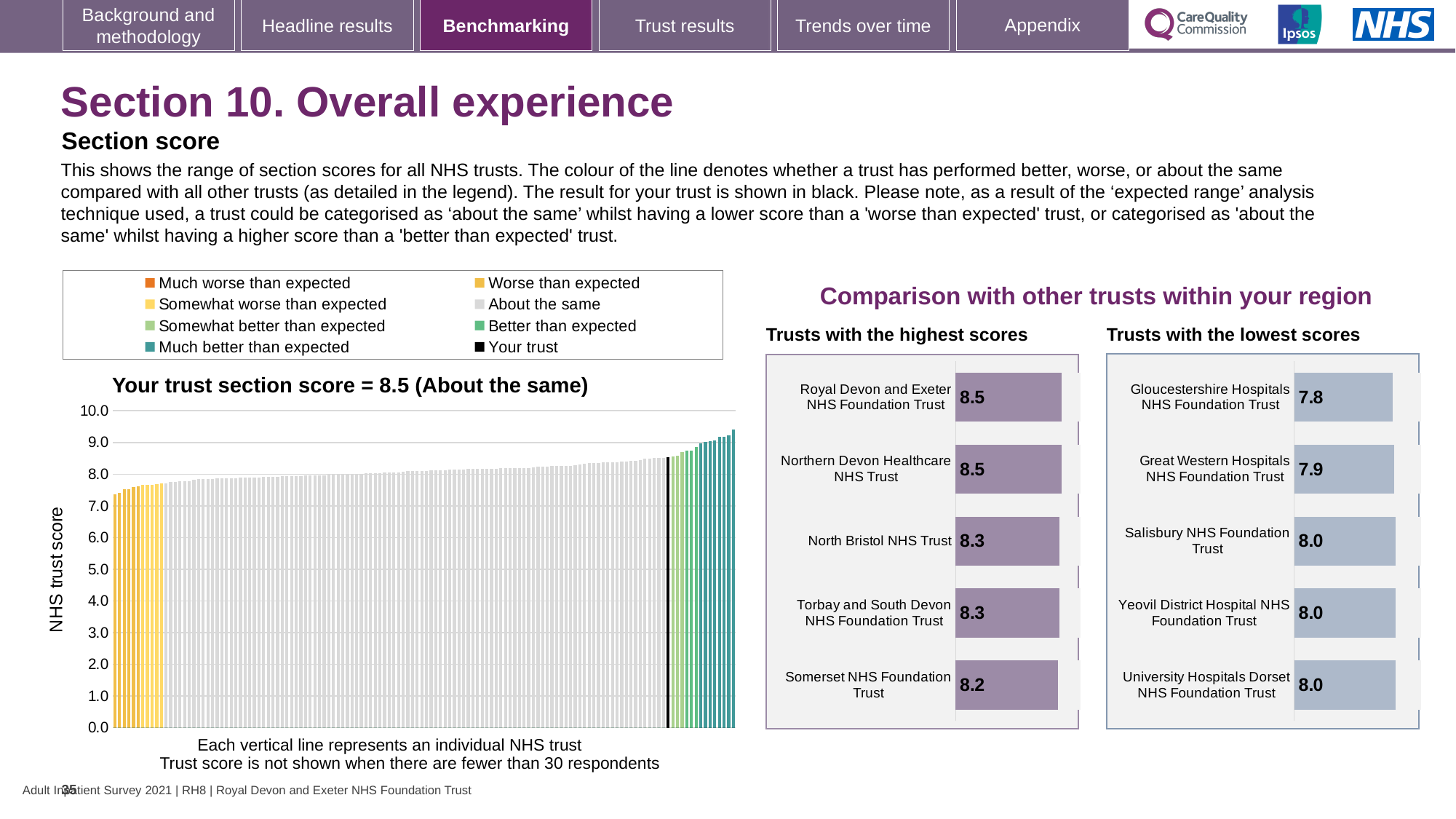
In the chart titled 'Trusts with the highest scores', what is the difference between the scores of Royal Devon and Exeter NHS Foundation Trust and Somerset NHS Foundation Trust? 0.3 How many trusts are shown in the chart titled 'Trusts with the lowest scores'? 5 In the chart titled 'Your trust section score = 8.5 (About the same)', is the value of the leftmost bar greater or less than 8.0? less In the chart titled 'Trusts with the highest scores', what is the score for North Bristol NHS Trust? 8.3 In the chart titled 'Your trust section score = 8.5 (About the same)', do the bars rise or fall from left to right? rise In the chart titled 'Trusts with the highest scores', which trust has the lowest score? Somerset NHS Foundation Trust In the chart titled 'Trusts with the lowest scores', which has the larger score: Great Western Hospitals NHS Foundation Trust or Gloucestershire Hospitals NHS Foundation Trust? Great Western Hospitals NHS Foundation Trust How many entries does the legend above the chart titled 'Your trust section score = 8.5 (About the same)' list? 8 In the chart titled 'Your trust section score = 8.5 (About the same)', what is the section score for your trust? 8.5 In the chart titled 'Your trust section score = 8.5 (About the same)', is the value of the rightmost bar greater or less than 9.0? greater In the chart titled 'Trusts with the lowest scores', which trust has the lowest score? Gloucestershire Hospitals NHS Foundation Trust In the chart titled 'Your trust section score = 8.5 (About the same)', what kind of chart is shown? bar chart